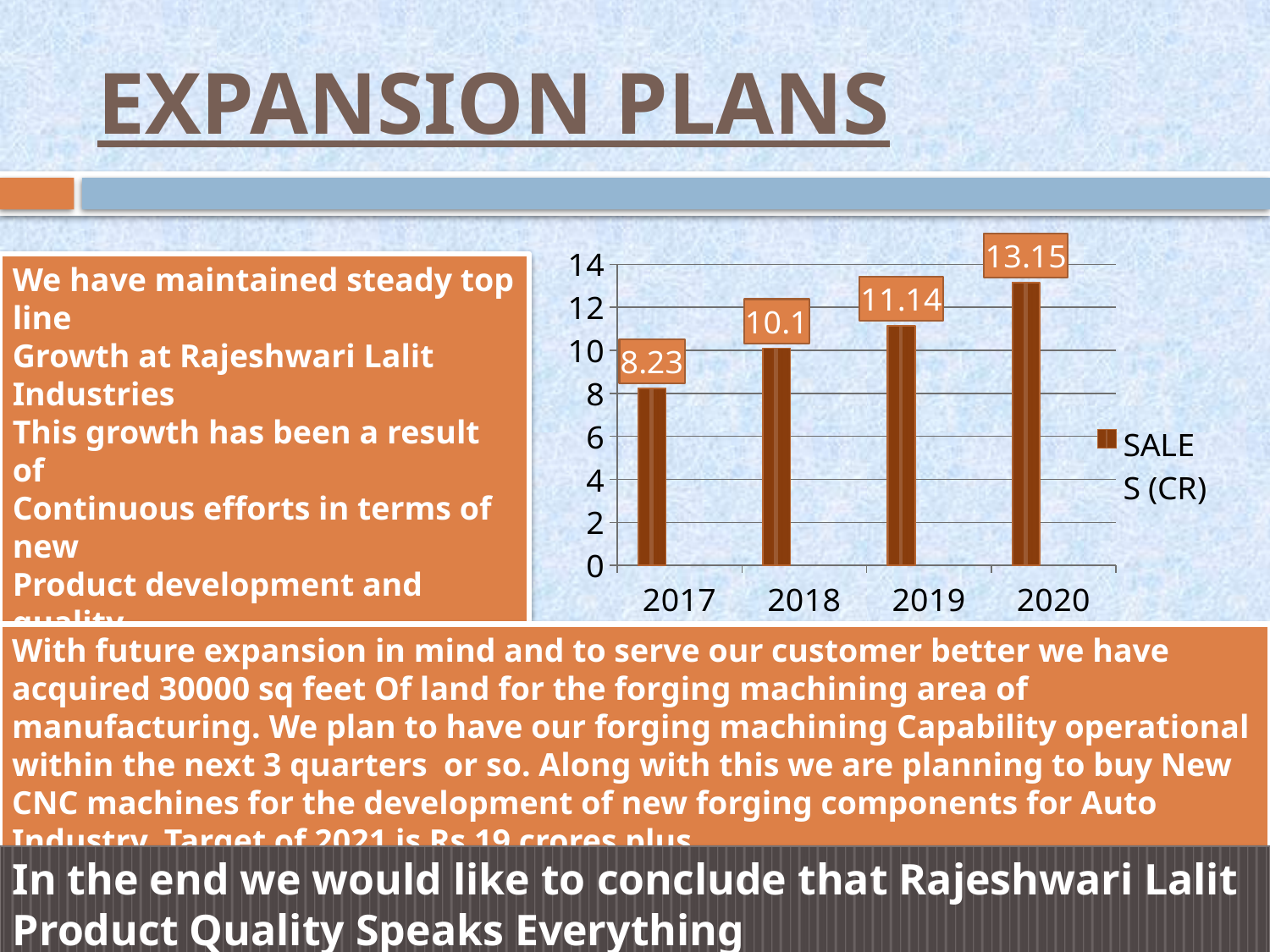
What is the value for 2018? 10.1 Is the value for 2018 greater or less than 8? greater What is the value for 2019? 11.14 Do the values rise or fall from 2017 to 2020? rise How many years are shown on the x axis? 4 What is the value for 2020? 13.15 Which is larger, the value for 2018 or the value for 2019? 2019 What is the value for 2017? 8.23 Which year has the highest value? 2020 What kind of chart is shown? bar chart What is the difference between the values for 2020 and 2017? 4.92 Which year has the lowest value? 2017